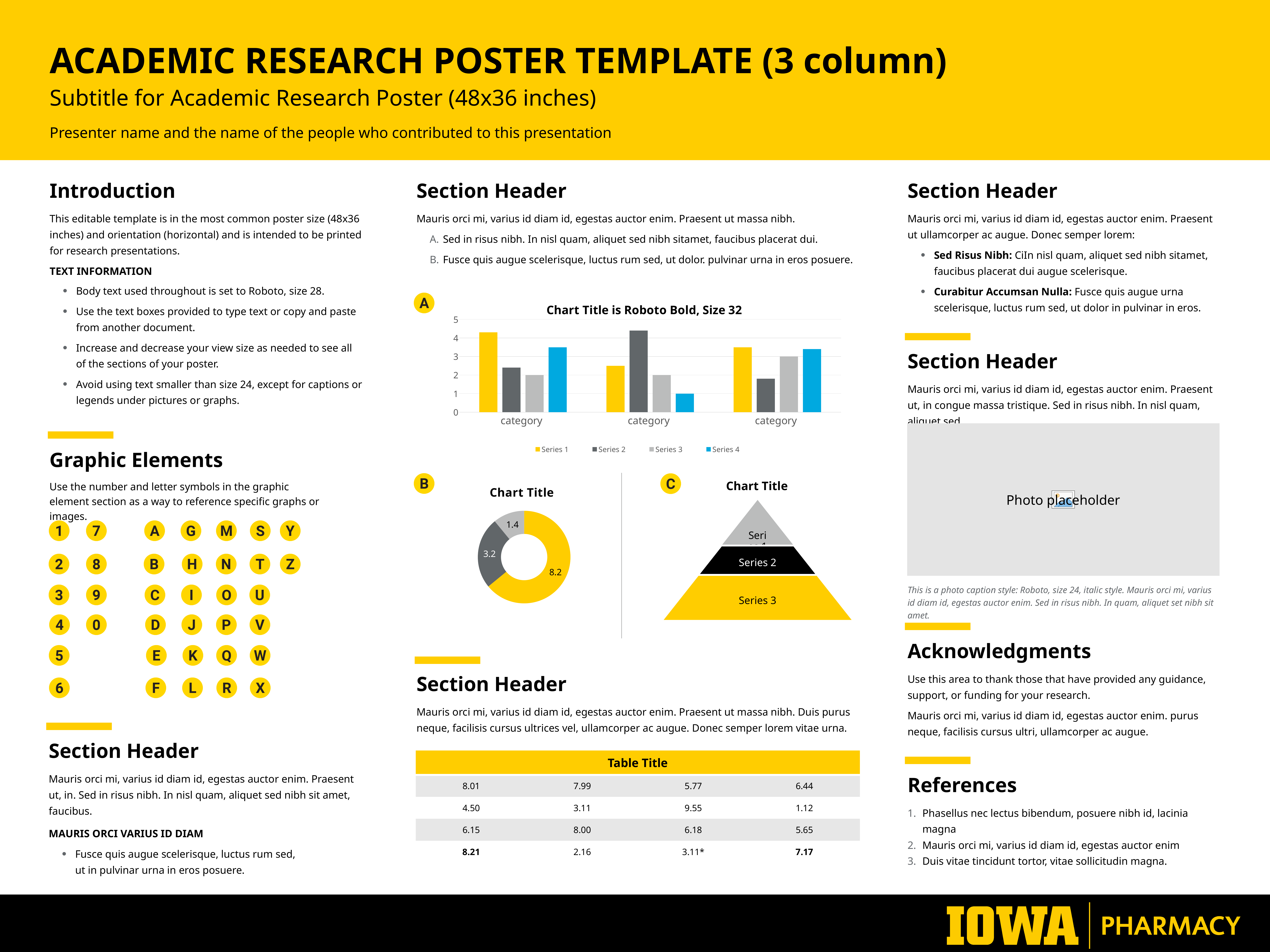
How many categories are shown on the x axis of chart A? 3 What kind of chart is chart A, titled "Chart Title is Roboto Bold, Size 32"? bar chart In chart A, is the Series 4 value for the second category greater or less than 2? less In chart A, is the Series 2 value for the second category greater or less than 4? greater In chart C, the pyramid chart, which series is shown in the bottom level? Series 3 How many series does the legend of chart A list? 4 In chart A, which colour represents Series 4 in the legend? blue In chart A, which series has the shortest bar in the second category? Series 4 In chart B, what is the difference between the largest slice (8.2) and the smallest slice (1.4)? 6.8 In chart A, which series has the tallest bar in the first category? Series 1 In chart B, what is the value of the largest slice? 8.2 What kind of chart is chart B? doughnut chart